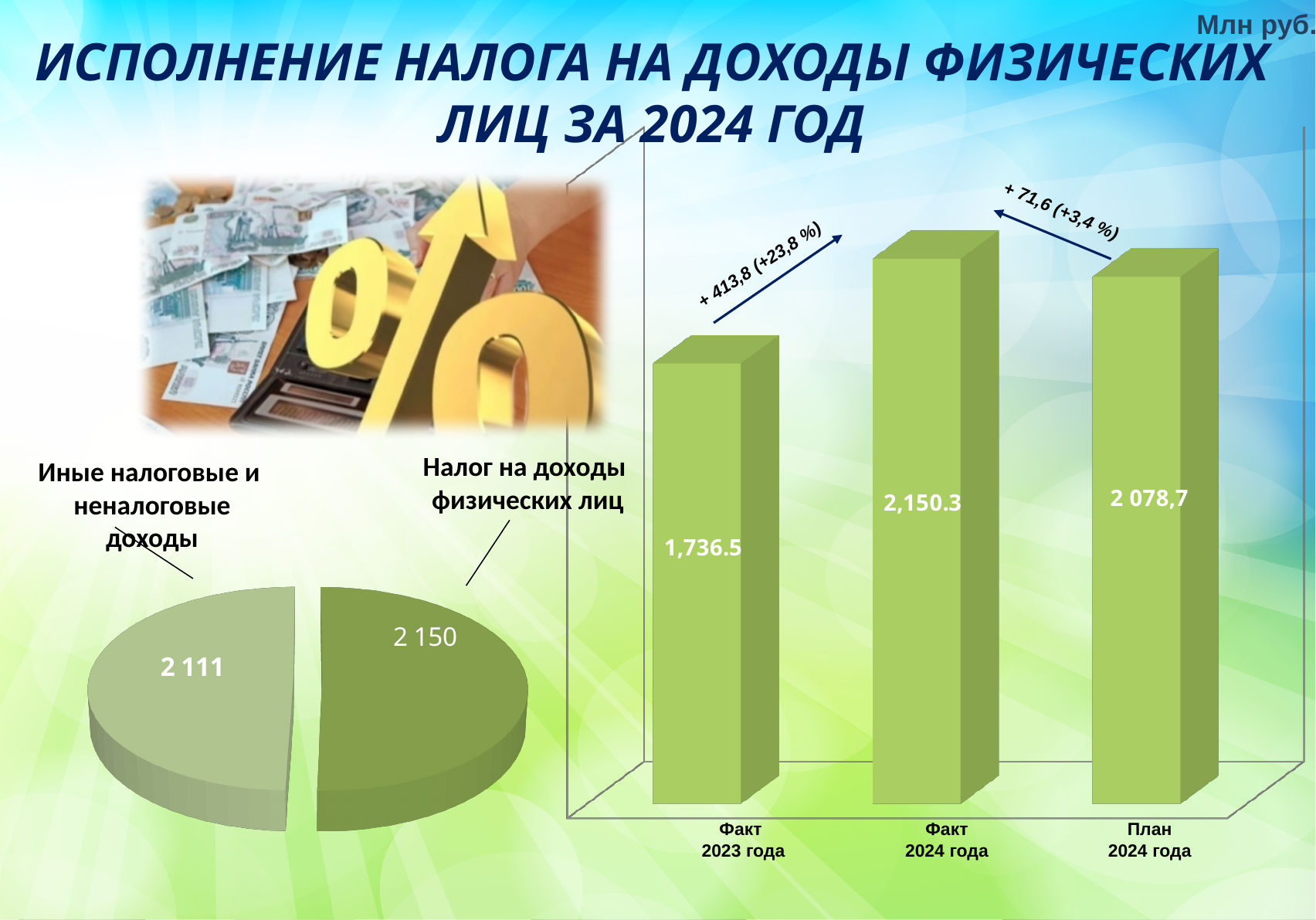
On the bar chart on the right, which is larger: Факт 2024 года or План 2024 года? Факт 2024 года On the bar chart on the right, which category has the lowest value? Факт 2023 года On the pie chart on the left, what is the value for Налог на доходы физических лиц? 2 150 How many bars are shown on the bar chart on the right? 3 On the bar chart on the right, what is the value for План 2024 года? 2 078,7 On the bar chart on the right, what is the difference between Факт 2024 года and Факт 2023 года? 413.8 On the bar chart on the right, what is the value for Факт 2023 года? 1,736.5 What type of chart is shown on the right side of the slide? Bar chart On the bar chart on the right, what is the value for Факт 2024 года? 2,150.3 On the bar chart on the right, which category has the highest value? Факт 2024 года On the pie chart on the left, what is the value for Иные налоговые и неналоговые доходы? 2 111 What unit of measurement is indicated in the top right corner of the slide? Млн руб.